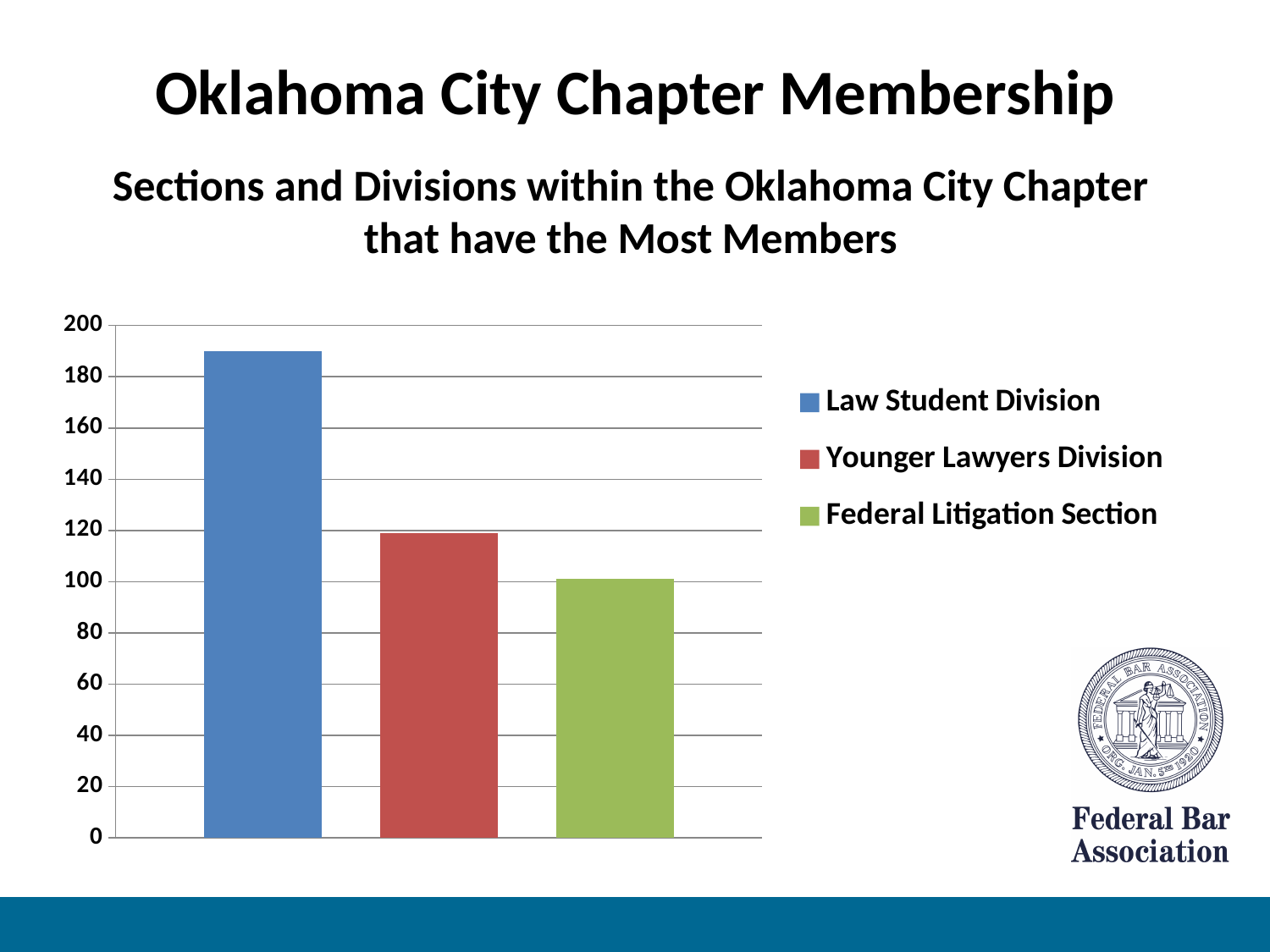
Is the value for the Younger Lawyers Division greater or less than 100? greater Which has more members, the Law Student Division or the Younger Lawyers Division? Law Student Division What colour is the bar for the Younger Lawyers Division? red Is the value for the Federal Litigation Section greater or less than 120? less Which section or division has the lowest membership in the chart? Federal Litigation Section Is the value for the Law Student Division greater or less than 200? less Which section or division has the highest membership in the chart? Law Student Division How many series does the legend list? 3 Which has more members, the Younger Lawyers Division or the Federal Litigation Section? Younger Lawyers Division What type of chart is shown on the slide? bar chart How many bars are plotted in the chart? 3